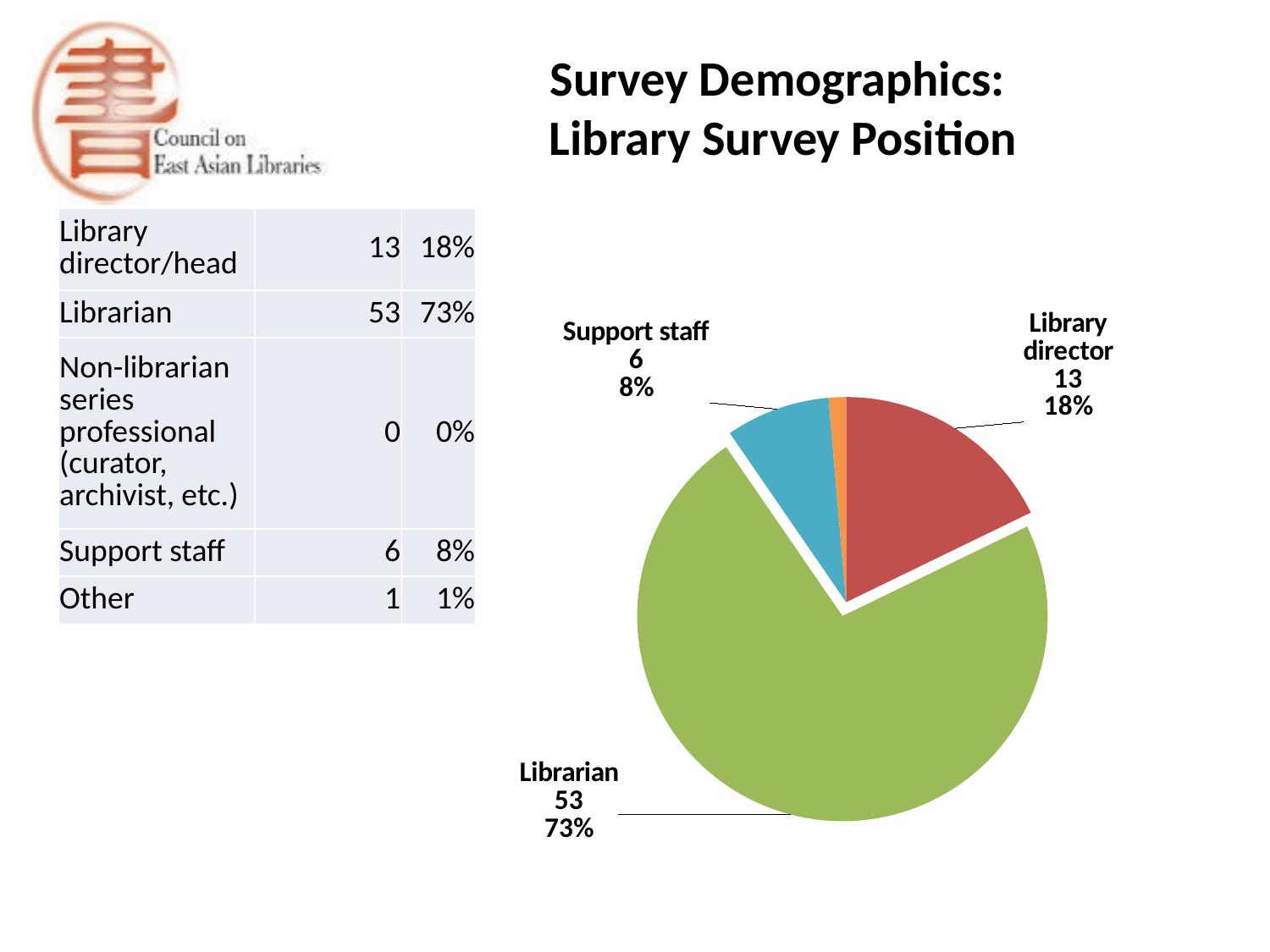
Which of the labeled slices is the smallest: Library director or Support staff? Support staff What share of the pie is the Library director slice? 18% What is the title of the slide containing the pie chart? Survey Demographics: Library Survey Position How many respondents are Librarians according to the pie chart? 53 What is the difference between the Librarian count and the Library director count in the pie chart? 40 How many respondents are Library directors according to the pie chart? 13 What percentage of the pie is the Support staff slice? 8% Which category has the largest slice in the pie chart? Librarian What percentage of the pie does the Librarian slice represent? 73% Which slice is larger, Library director or Support staff? Library director What kind of chart is shown on the slide? pie chart What is the value shown for Support staff in the pie chart? 6